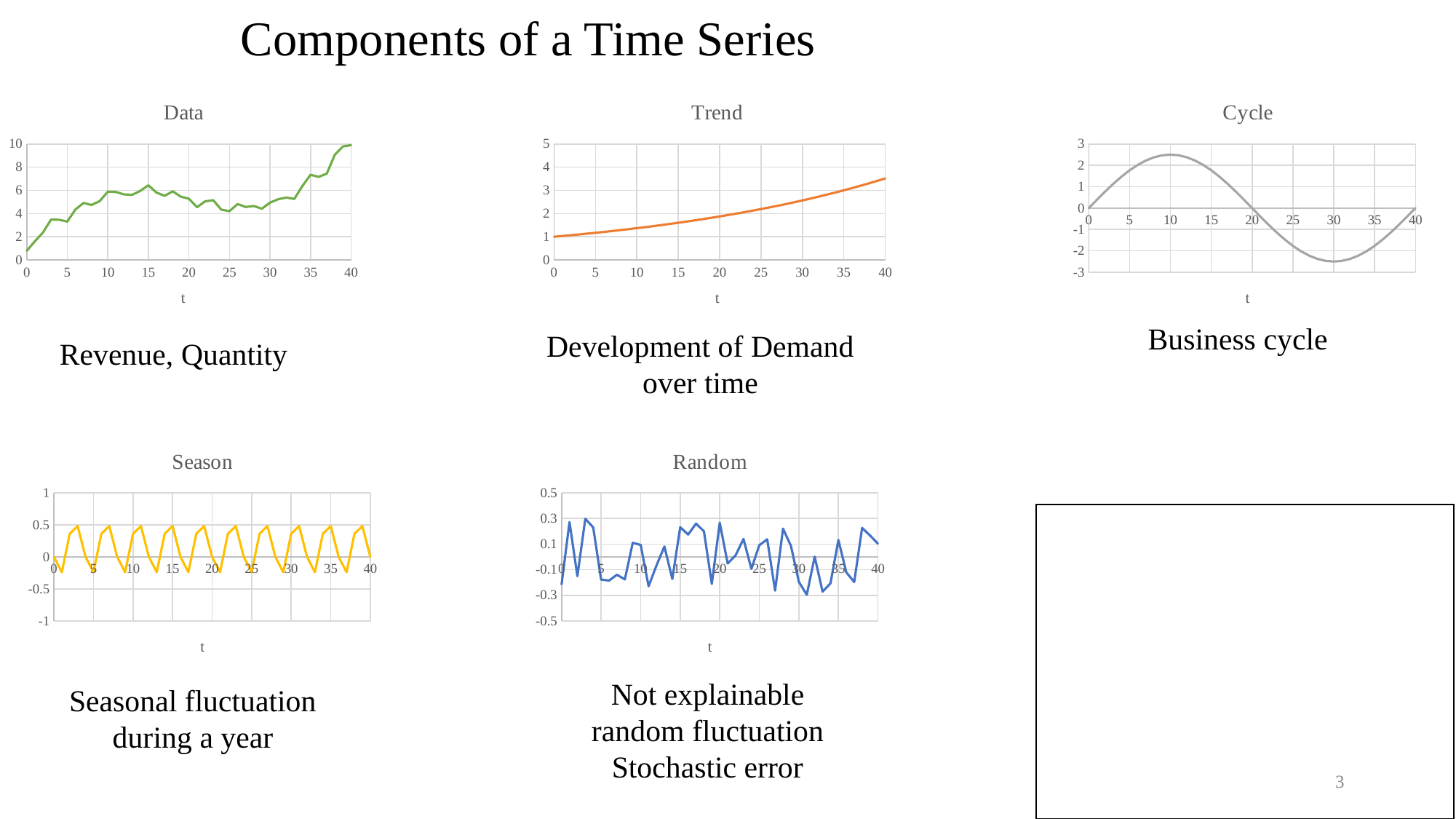
In the 'Season' chart, is the highest value reached greater or less than 1? less In the 'Data' chart, which is larger: the value at t = 0 or the value at t = 40? t = 40 In the 'Cycle' chart, is the value at t = 30 greater or less than -2? less What is the x-axis label on the 'Season' chart? t In the 'Trend' chart, is the value at t = 40 greater or less than 3? greater What is the title of the chart at the top right of the slide? Cycle In the 'Trend' chart, do the values rise or fall as t increases? rise What kind of chart is the 'Data' chart? line chart